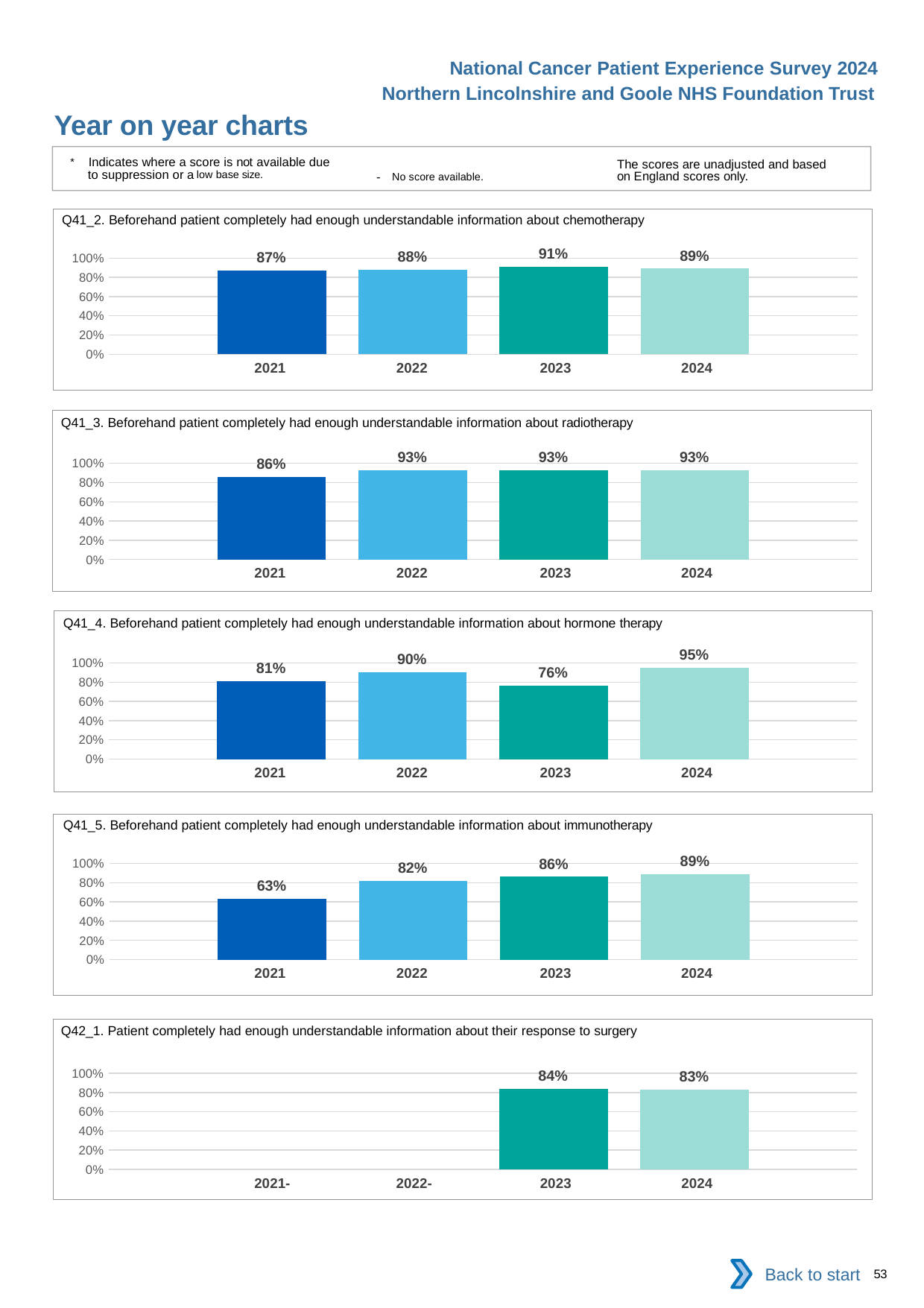
In the Q41_2 chemotherapy chart, what is the value for 2023? 91% How many charts are shown on the slide? 5 In the Q41_4 hormone therapy chart, what is the difference between the 2024 and 2023 values? 19% In the Q41_3 radiotherapy chart, which year has the lowest value? 2021 In the Q41_5 immunotherapy chart, what is the value for 2021? 63% In the Q41_4 hormone therapy chart, what is the value for 2022? 90% What type of chart is the Q41_3 radiotherapy chart? bar chart In the Q41_4 hormone therapy chart, which year has the highest value? 2024 In the Q42_1 surgery chart, which is larger, the value for 2023 or 2024? 2023 How many bars are plotted in the Q42_1 surgery chart? 2 In the Q41_5 immunotherapy chart, do the values rise or fall from 2021 to 2024? rise In the Q41_2 chemotherapy chart, what is the difference between the 2023 and 2021 values? 4%